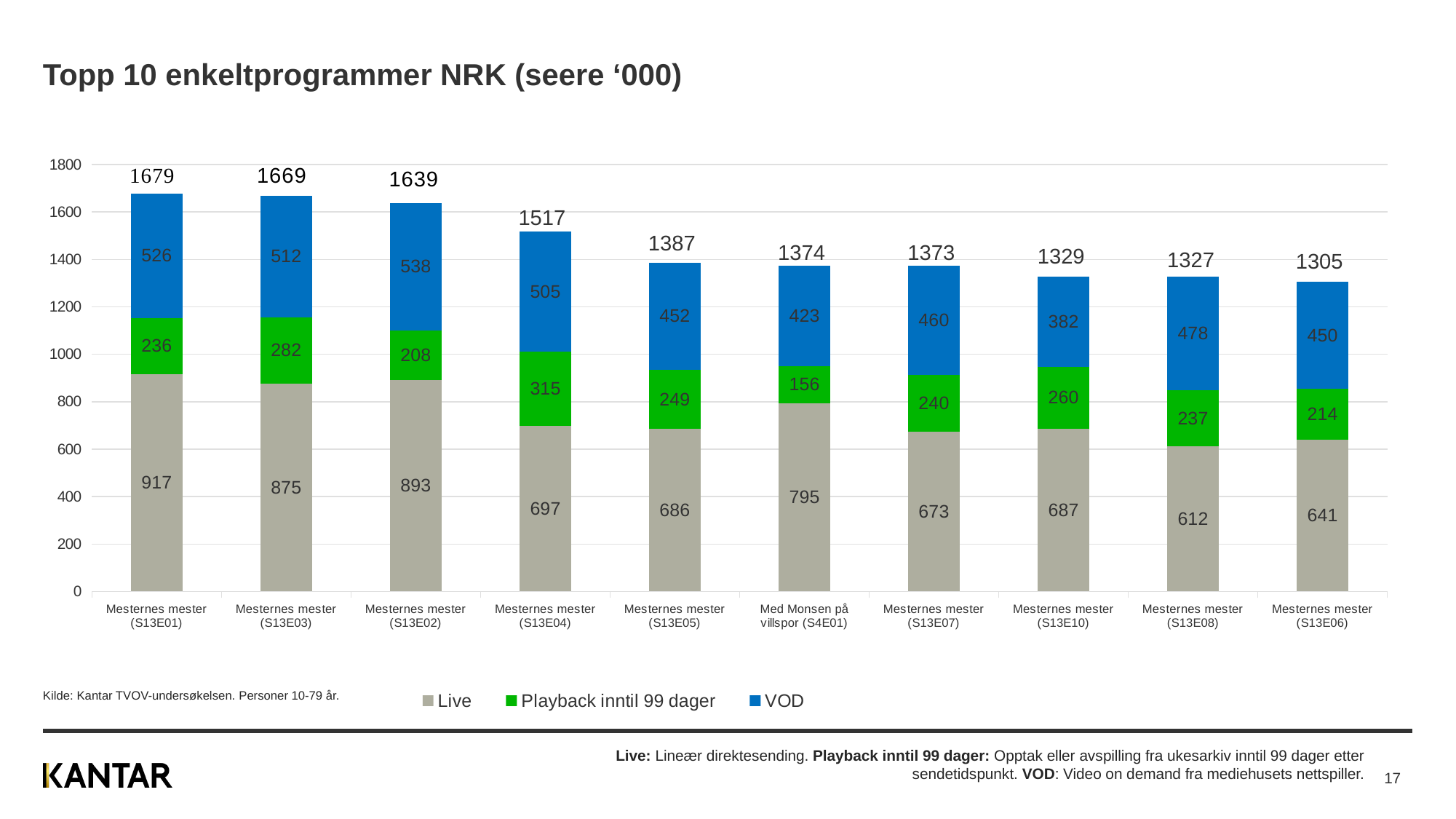
What is the total for Mesternes mester (S13E04)? 1517 What is the Playback inntil 99 dager value for Med Monsen på villspor (S4E01)? 156 How many programmes (categories) are shown on the x axis? 10 What is the Live value for Mesternes mester (S13E01)? 917 Which is larger: the Live value for Mesternes mester (S13E03) or the Live value for Mesternes mester (S13E08)? Mesternes mester (S13E03) Which programme has the highest total? Mesternes mester (S13E01) Which programme has the lowest total? Mesternes mester (S13E06) What is the VOD value for Mesternes mester (S13E02)? 538 What type of chart is shown on the slide? Stacked bar chart Which series is shown in blue in the legend? VOD How many series does the legend list? 3 What is the difference between the totals of Mesternes mester (S13E01) and Mesternes mester (S13E06)? 374